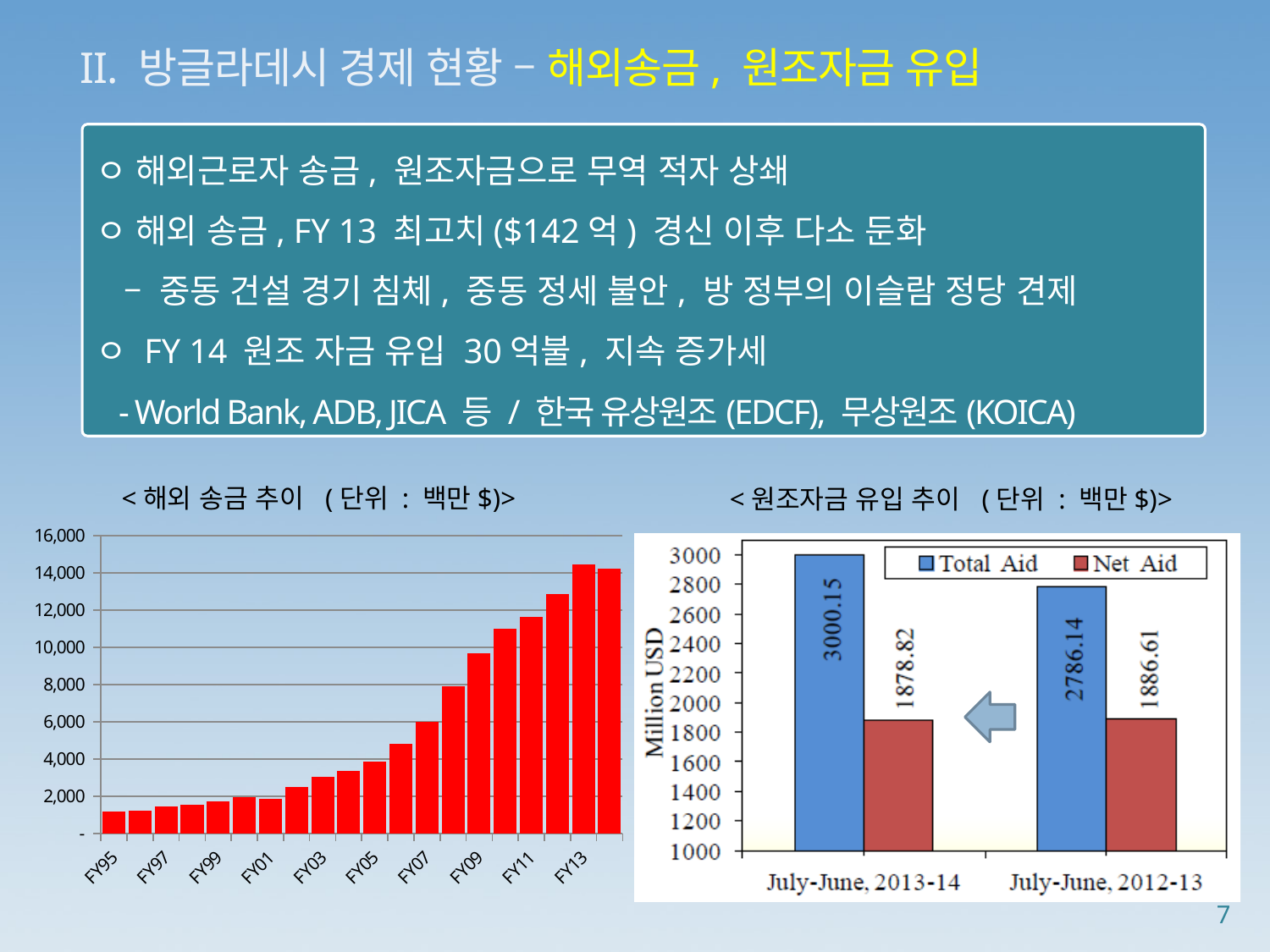
In the left chart (해외 송금 추이), is the value for FY13 greater or less than 14,000? greater In the right chart (원조자금 유입 추이), how much higher is Total Aid in July-June, 2013-14 than in July-June, 2012-13? 214.01 In the left chart (해외 송금 추이), do the values generally rise or fall from FY95 to FY13? rise What is the y-axis label of the right chart (원조자금 유입 추이)? Million USD How many series does the legend of the right chart (원조자금 유입 추이) list? 2 What kind of chart is the left chart (해외 송금 추이)? bar chart In the right chart (원조자금 유입 추이), what is the Total Aid value for July-June, 2013-14? 3000.15 In the left chart (해외 송금 추이), is the value for FY95 greater or less than 2,000? less In the right chart (원조자금 유입 추이), what is the Net Aid value for July-June, 2012-13? 1886.61 In the right chart (원조자금 유입 추이), what is the difference between Total Aid and Net Aid for July-June, 2013-14? 1121.33 In the right chart (원조자금 유입 추이), which period has the larger Total Aid, July-June, 2013-14 or July-June, 2012-13? July-June, 2013-14 In the right chart (원조자금 유입 추이), what is the Net Aid value for July-June, 2013-14? 1878.82